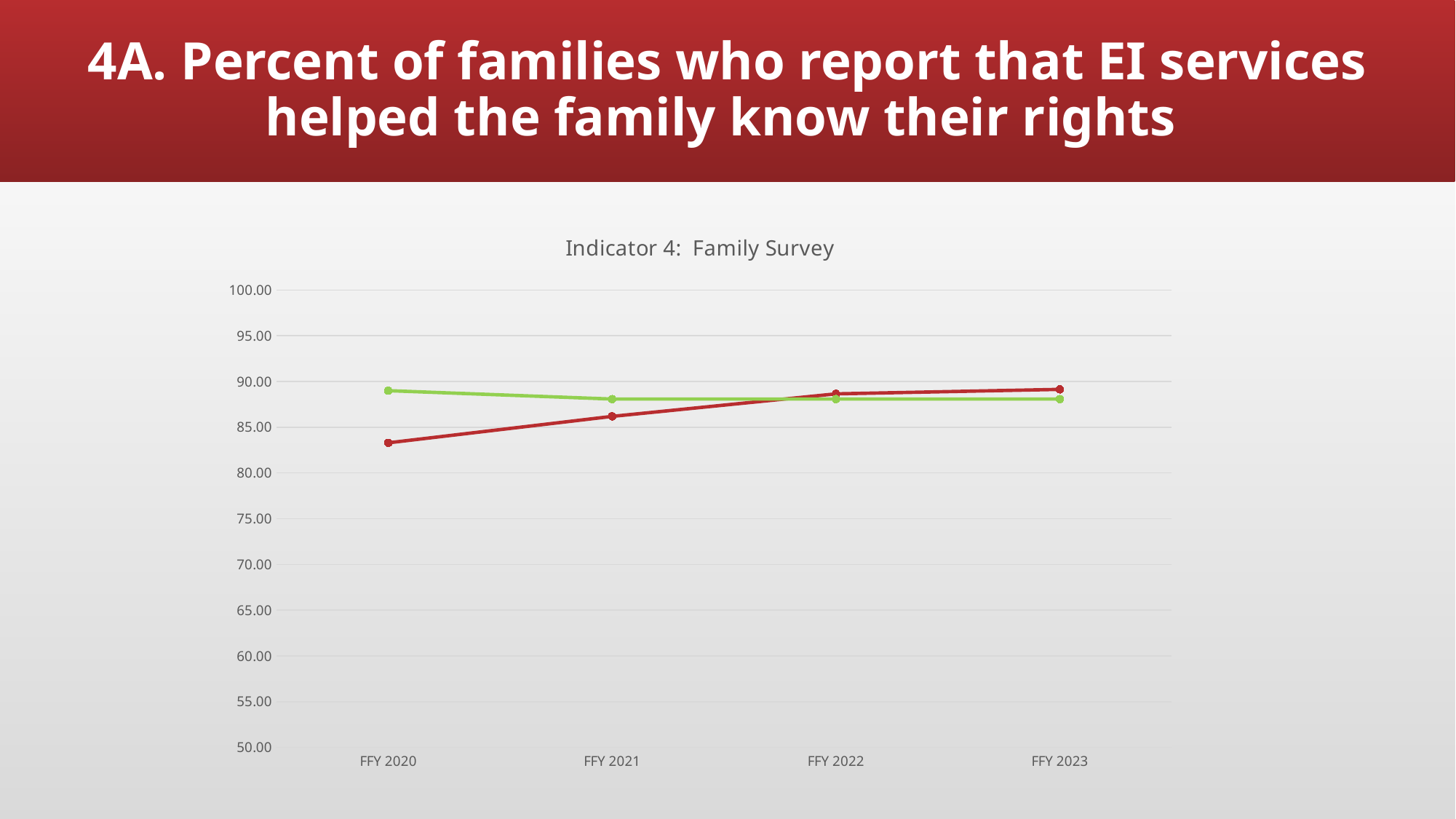
What kind of chart is shown on the slide? line chart At FFY 2021, which line is higher, the red line or the green line? green line In which FFY is the green line at its highest value? FFY 2020 Is the value of the red line for FFY 2021 greater or less than 85? greater In which FFY is the red line at its lowest value? FFY 2020 What is the title of the chart? Indicator 4: Family Survey Is the value of the red line for FFY 2020 greater or less than 85? less Is the value of the green line for FFY 2020 greater or less than 90? less Does the red line rise or fall from FFY 2020 to FFY 2023? rise At FFY 2020, which line is higher, the red line or the green line? green line How many FFY categories are shown on the x axis? 4